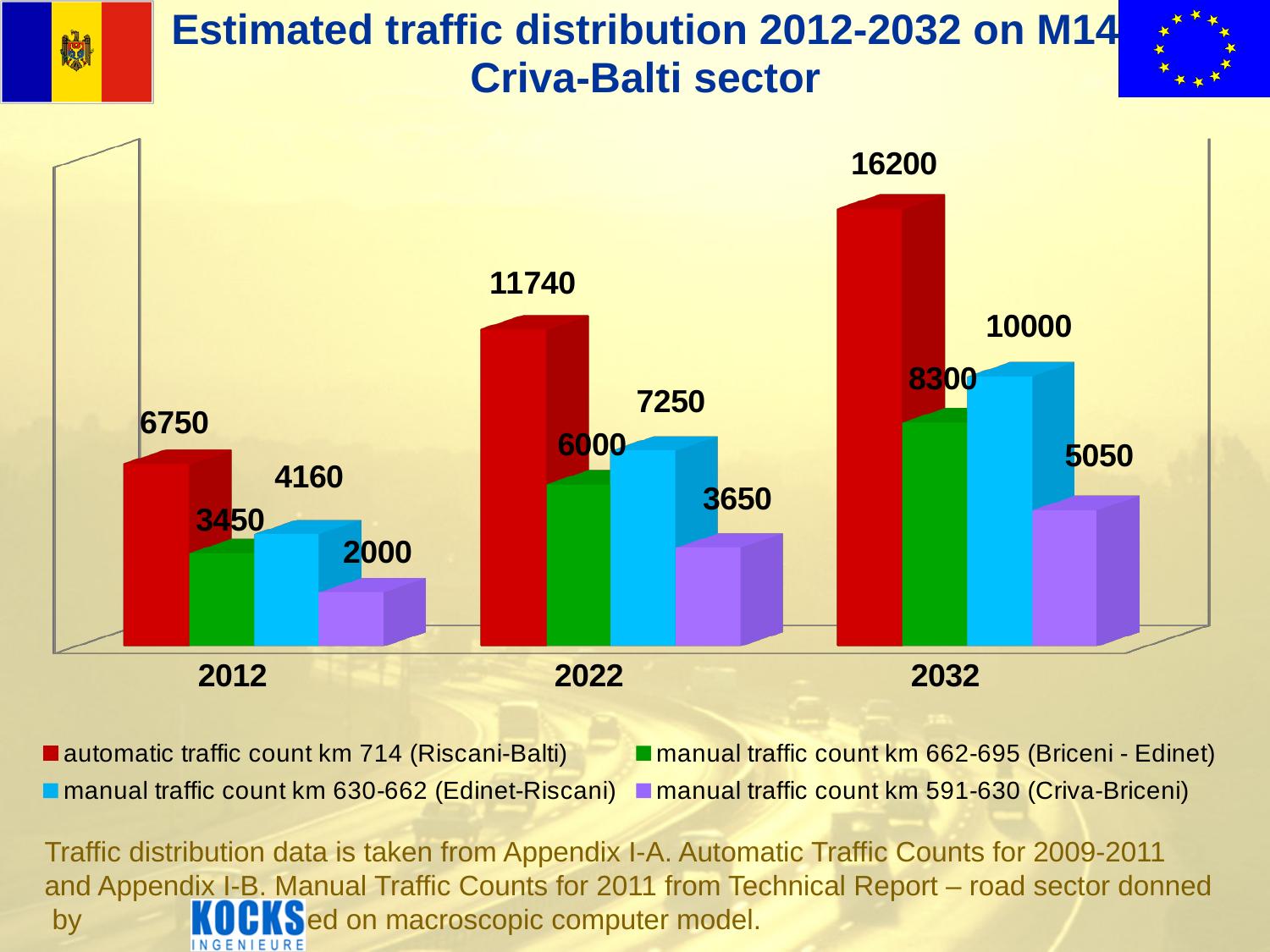
Which series has the lowest value in 2022? manual traffic count km 591-630 (Criva-Briceni) What kind of chart is shown on the slide? bar chart What is the value for manual traffic count km 591-630 (Criva-Briceni) in 2012? 2000 How many series does the legend list? 4 What is the value for automatic traffic count km 714 (Riscani-Balti) in 2032? 16200 What is the value for manual traffic count km 662-695 (Briceni - Edinet) in 2032? 8300 Do the values for manual traffic count km 591-630 (Criva-Briceni) rise or fall from 2012 to 2032? rise Which year has the highest value for automatic traffic count km 714 (Riscani-Balti)? 2032 Which is larger in 2012: manual traffic count km 662-695 (Briceni - Edinet) or manual traffic count km 630-662 (Edinet-Riscani)? manual traffic count km 630-662 (Edinet-Riscani) How many years are shown on the x axis of the chart? 3 What is the value for manual traffic count km 630-662 (Edinet-Riscani) in 2022? 7250 What is the difference between the automatic traffic count km 714 (Riscani-Balti) values for 2032 and 2012? 9450